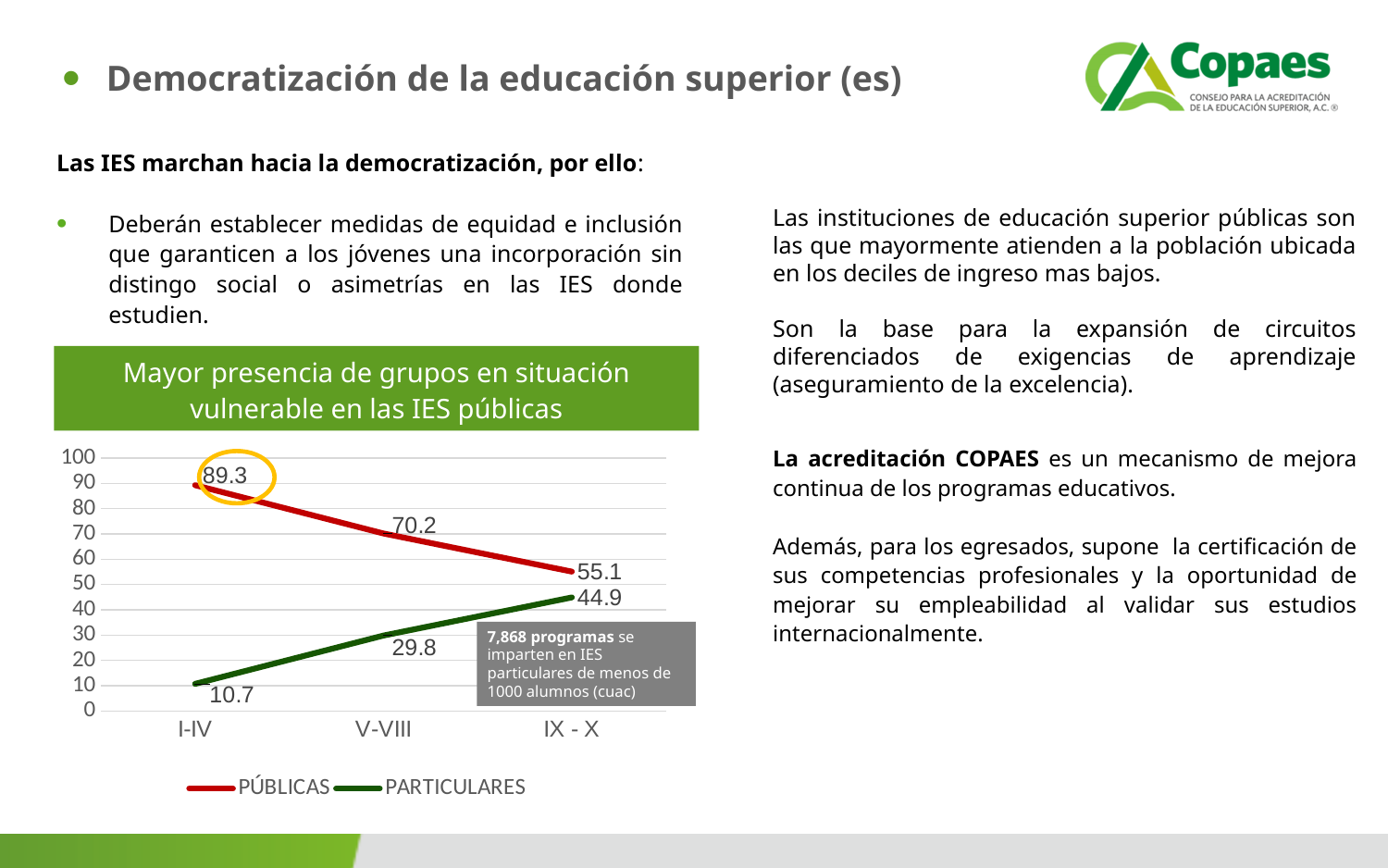
How many categories are shown on the x axis? 3 What is the value for PÚBLICAS at IX - X? 55.1 What is the value for PÚBLICAS at I-IV? 89.3 At which category does the PARTICULARES series reach its highest value? IX - X Which series has the larger value at V-VIII, PÚBLICAS or PARTICULARES? PÚBLICAS How many series does the legend list? 2 What is the value for PARTICULARES at V-VIII? 29.8 At which category does the PÚBLICAS series reach its lowest value? IX - X What kind of chart is shown on the slide? Line chart What is the difference between PÚBLICAS and PARTICULARES at I-IV? 78.6 What is the value for PARTICULARES at I-IV? 10.7 Does the PÚBLICAS series rise or fall from I-IV to IX - X? Fall